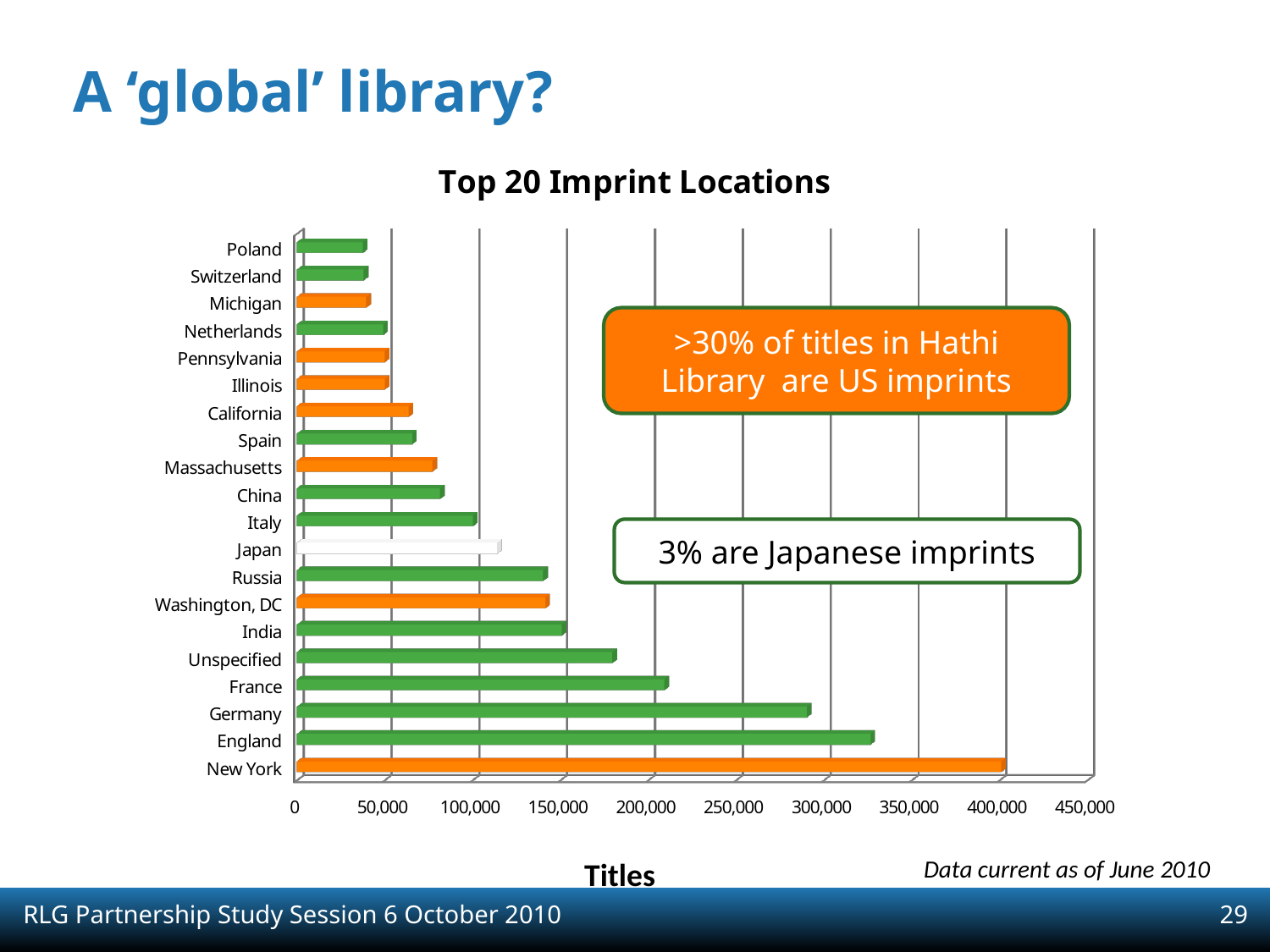
What is the label on the horizontal axis of the chart? Titles Which imprint location has the highest number of titles? New York Which has more titles, Germany or France? Germany What is the title of the chart? Top 20 Imprint Locations How many imprint locations are plotted in the chart? 20 What kind of chart is shown on the slide? bar chart Is the value for China greater or less than 100,000? less Is the value for Germany greater or less than 300,000? less Is the value for England greater or less than 300,000? greater Which has more titles, England or Germany? England Which has more titles, France or Unspecified? France